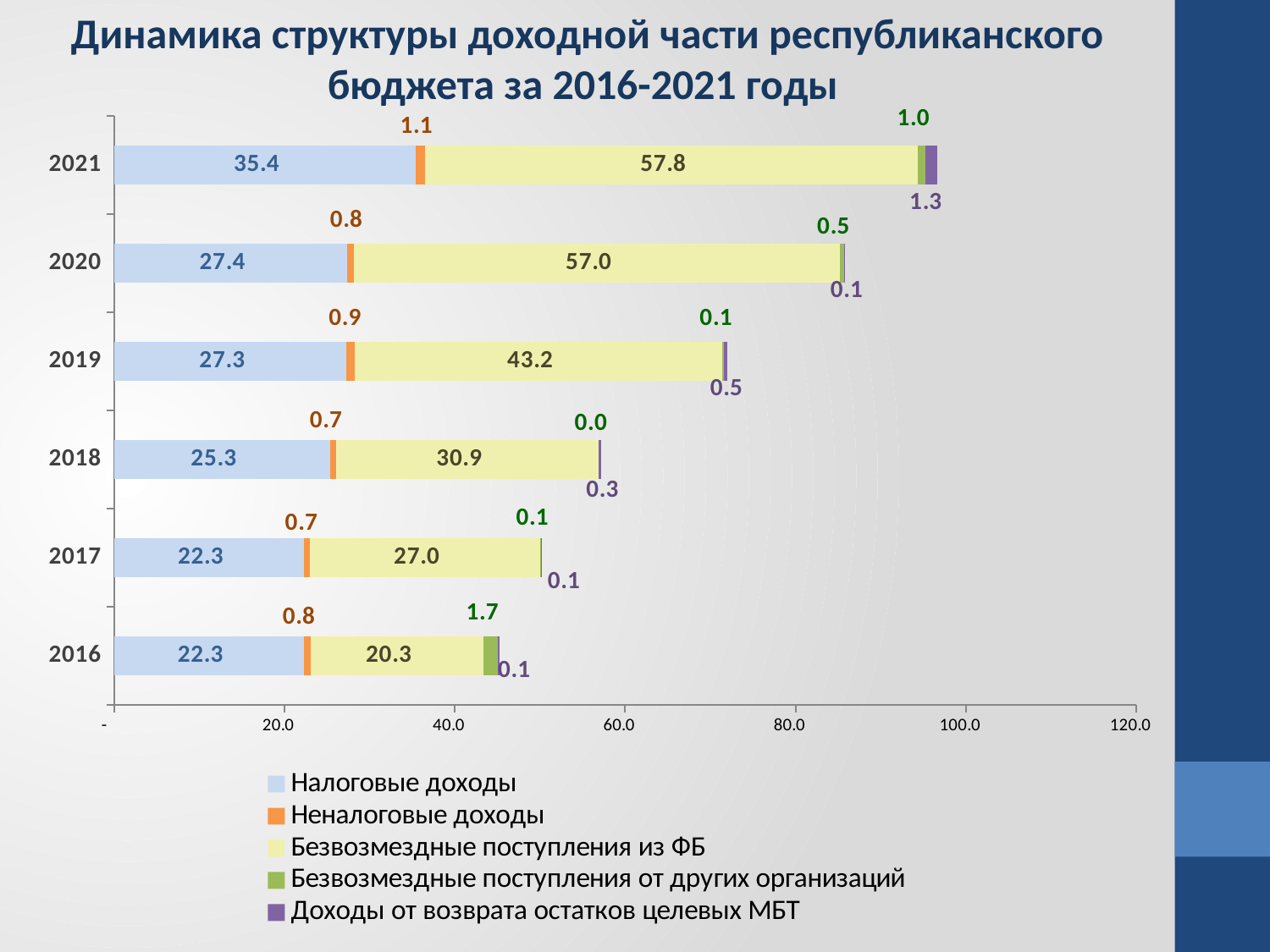
What is the value of Налоговые доходы for 2021? 35.4 How many series does the legend list? 5 Which year has the highest value of Безвозмездные поступления из ФБ? 2021 What is the total of the stacked bar for 2020? 85.8 What is the difference between Налоговые доходы in 2021 and in 2020? 8.0 What is the value of Безвозмездные поступления из ФБ for 2019? 43.2 Which legend entry is shown in orange? Неналоговые доходы Which is larger: Безвозмездные поступления из ФБ in 2018 or Налоговые доходы in 2018? Безвозмездные поступления из ФБ Which year has the lowest value of Безвозмездные поступления из ФБ? 2016 What kind of chart is shown on the slide? Stacked bar chart What is the value of Безвозмездные поступления от других организаций for 2016? 1.7 How many years are shown on the chart? 6